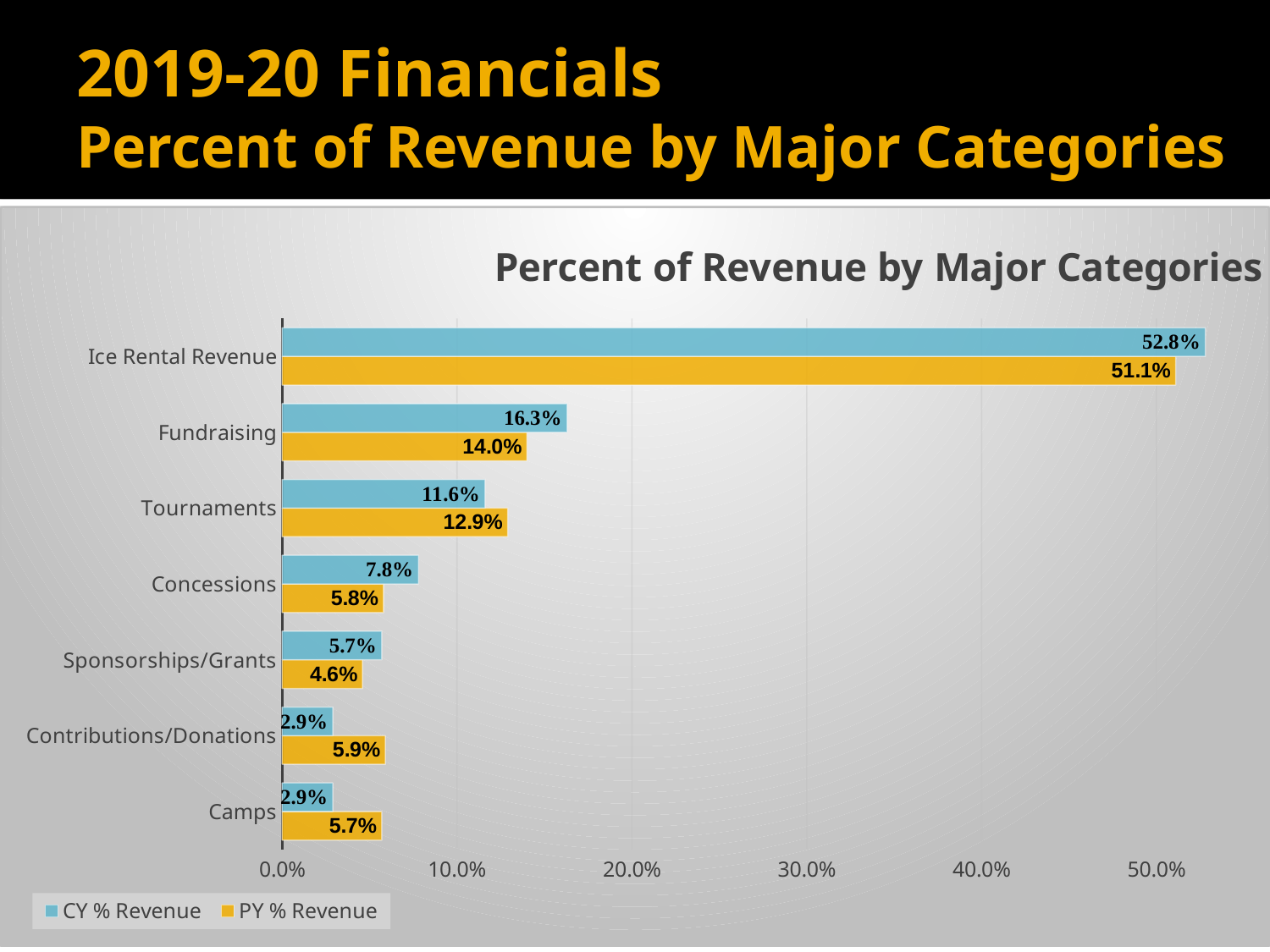
Which is larger for Concessions: CY % Revenue or PY % Revenue? CY % Revenue What is the PY % Revenue value for Fundraising? 14.0% What is the PY % Revenue value for Contributions/Donations? 5.9% What is the title of the chart? Percent of Revenue by Major Categories What is the CY % Revenue value for Ice Rental Revenue? 52.8% What kind of chart is shown on the slide? Bar chart Which category has the lowest PY % Revenue? Sponsorships/Grants How many categories are shown on the chart? 7 What is the difference between the CY % Revenue and PY % Revenue for Tournaments? 1.3% How many series does the legend list? 2 Is the CY % Revenue value for Fundraising greater or less than 20.0%? less Which category has the highest CY % Revenue? Ice Rental Revenue